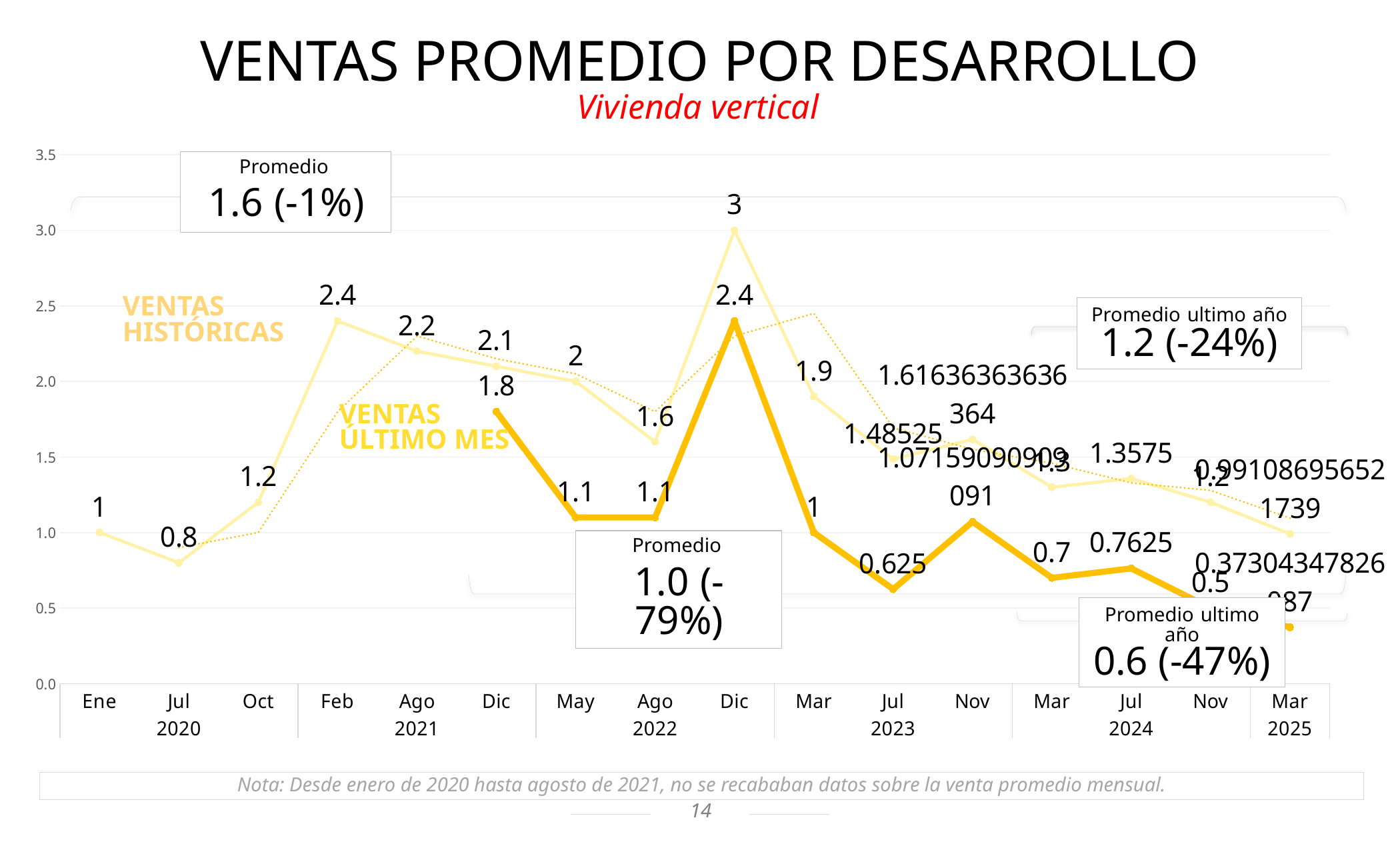
What is the value of VENTAS ÚLTIMO MES for Nov 2024? 0.5 What is the value of VENTAS HISTÓRICAS for Dic 2022? 3 What value is shown in the 'Promedio ultimo año' box at the top right of the chart? 1.2 (-24%) What kind of chart is shown on the slide? line chart What is the difference between the VENTAS HISTÓRICAS values for Feb 2021 and Jul 2020? 1.6 What is the value of VENTAS ÚLTIMO MES for Jul 2023? 0.625 In which month does VENTAS HISTÓRICAS reach its highest value? Dic 2022 What is the value of VENTAS ÚLTIMO MES for Dic 2022? 2.4 In which month does VENTAS HISTÓRICAS have its lowest value? Jul 2020 For Dic 2021, which series has the larger value, VENTAS HISTÓRICAS or VENTAS ÚLTIMO MES? VENTAS HISTÓRICAS What is the value of VENTAS HISTÓRICAS for Feb 2021? 2.4 In which month does VENTAS ÚLTIMO MES reach its highest value? Dic 2022